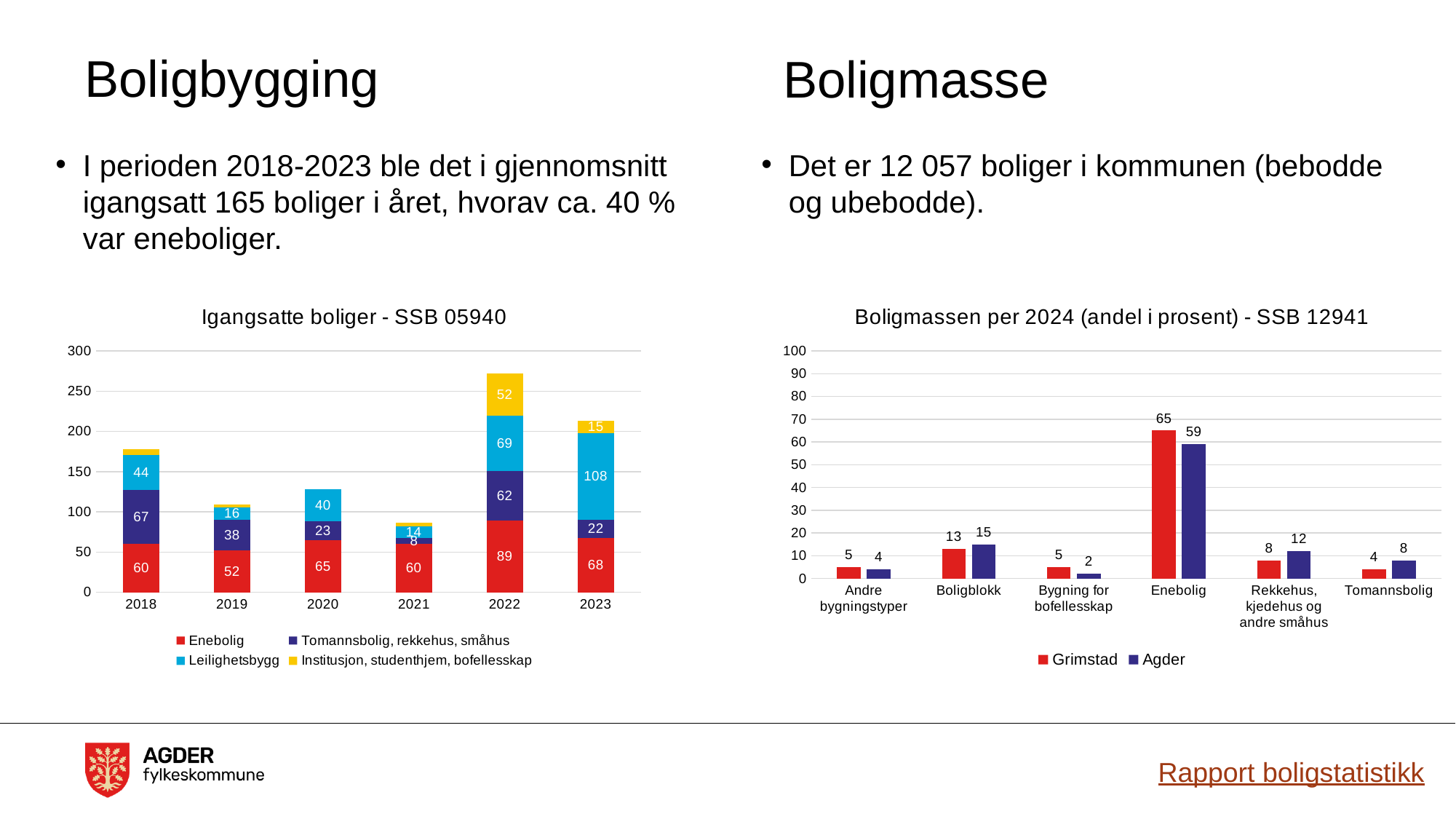
In the chart 'Igangsatte boliger - SSB 05940', what is the total of the stacked bar for 2022? 272 In the chart 'Igangsatte boliger - SSB 05940', what is the total of the stacked bar for 2023? 213 In the chart 'Boligmassen per 2024 (andel i prosent) - SSB 12941', what is the difference between the Agder and Grimstad values for Rekkehus, kjedehus og andre småhus? 4 In the chart 'Igangsatte boliger - SSB 05940', how many series does the legend list? 4 In the chart 'Igangsatte boliger - SSB 05940', which year has the lowest total stacked bar? 2021 In the chart 'Boligmassen per 2024 (andel i prosent) - SSB 12941', what is the Grimstad value for Enebolig? 65 What kind of chart is 'Boligmassen per 2024 (andel i prosent) - SSB 12941'? bar chart In the chart 'Igangsatte boliger - SSB 05940', what is the Enebolig value for 2022? 89 In the chart 'Igangsatte boliger - SSB 05940', is the total for 2019 greater or less than 150? less In the chart 'Igangsatte boliger - SSB 05940', what is the Leilighetsbygg value for 2023? 108 In the chart 'Boligmassen per 2024 (andel i prosent) - SSB 12941', how many categories are shown on the x axis? 6 In the chart 'Boligmassen per 2024 (andel i prosent) - SSB 12941', which is larger for Boligblokk, Grimstad or Agder? Agder